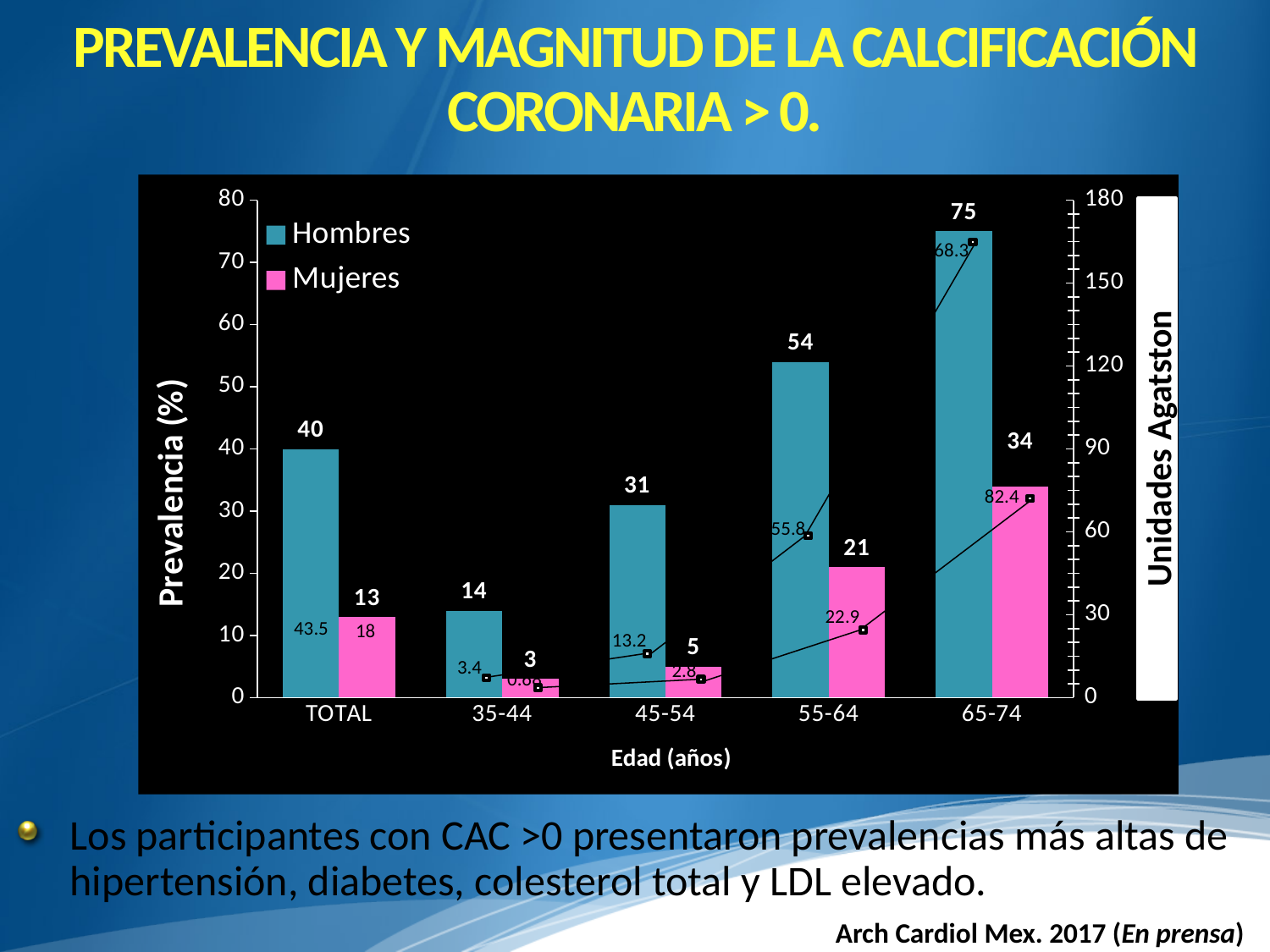
What is the label of the right-hand vertical axis? Unidades Agatston What is the prevalence (%) for Mujeres in the 55-64 age group? 21 What is the prevalence (%) for Hombres in the 65-74 age group? 75 Which age group has the lowest prevalence for Mujeres? 35-44 How many age categories are shown on the x axis? 5 Which is larger, the prevalence for Hombres in the 45-54 age group or for Mujeres in the 65-74 age group? Mujeres in 65-74 What is the prevalence (%) for Hombres in the TOTAL category? 40 Which age group has the highest prevalence for Hombres? 65-74 Do the prevalence values for Hombres rise or fall from the 35-44 to the 65-74 age group? rise What is the difference in prevalence (%) between Hombres and Mujeres in the 65-74 age group? 41 How many series does the legend list? 2 What is the prevalence (%) for Mujeres in the 35-44 age group? 3